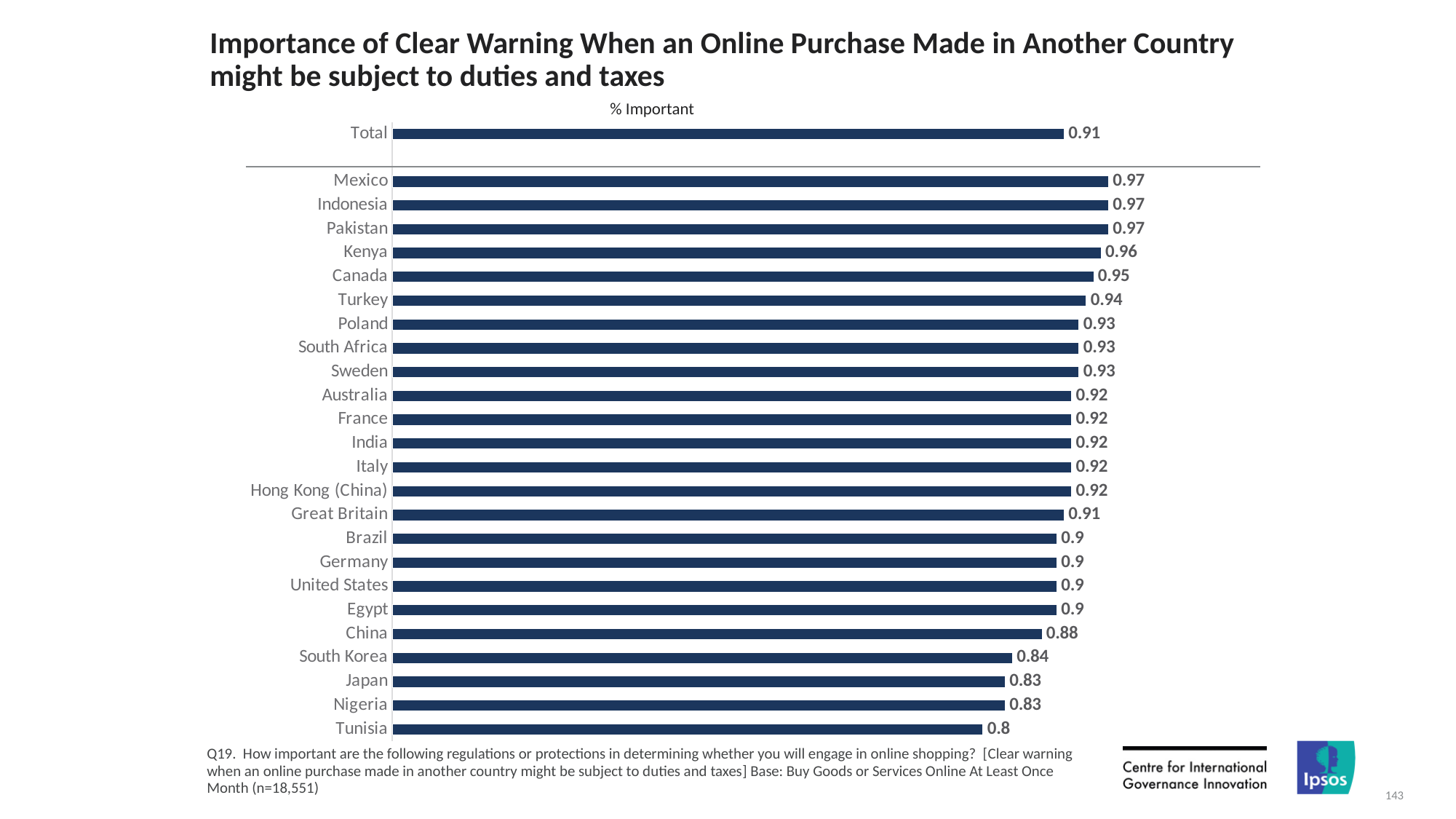
Which has a larger value, Turkey or Japan? Turkey How many countries are listed below the Total bar? 24 Which has a larger value, Nigeria or Poland? Poland What is the difference between the values for Kenya and South Korea? 0.12 Which category has the lowest value? Tunisia What is the value for Canada? 0.95 What is the value for China? 0.88 What is the value for Tunisia? 0.8 What is the label shown above the chart area, under the title? % Important What is the value for the Total bar? 0.91 What is the difference between the values for Mexico and Tunisia? 0.17 What kind of chart is shown on the slide? Bar chart